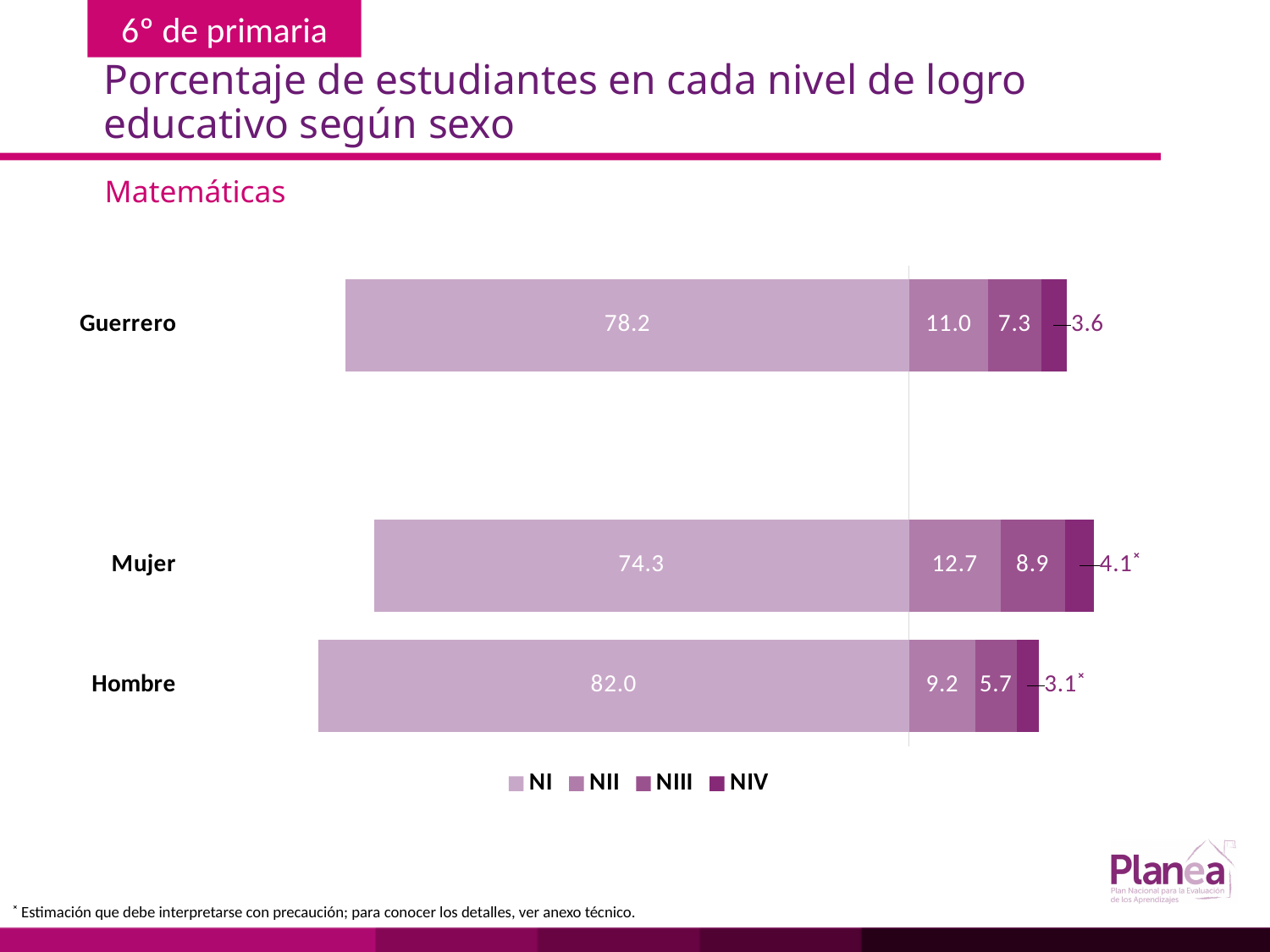
What is the difference between the NI values for Hombre and Mujer? 7.7 Which is larger, the NII value for Guerrero or the NII value for Mujer? Mujer What is the NII value for Mujer? 12.7 What is the NI value for Guerrero? 78.2 What is the NIII value for Guerrero? 7.3 How many series does the legend list? 4 What is the total of the stacked bar for Mujer? 100.0 How many categories are shown on the chart? 3 Which category has the lowest NIV value? Hombre What is the NIV value for Hombre? 3.1 Which category has the highest NI value? Hombre What kind of chart is shown on the slide? Stacked bar chart